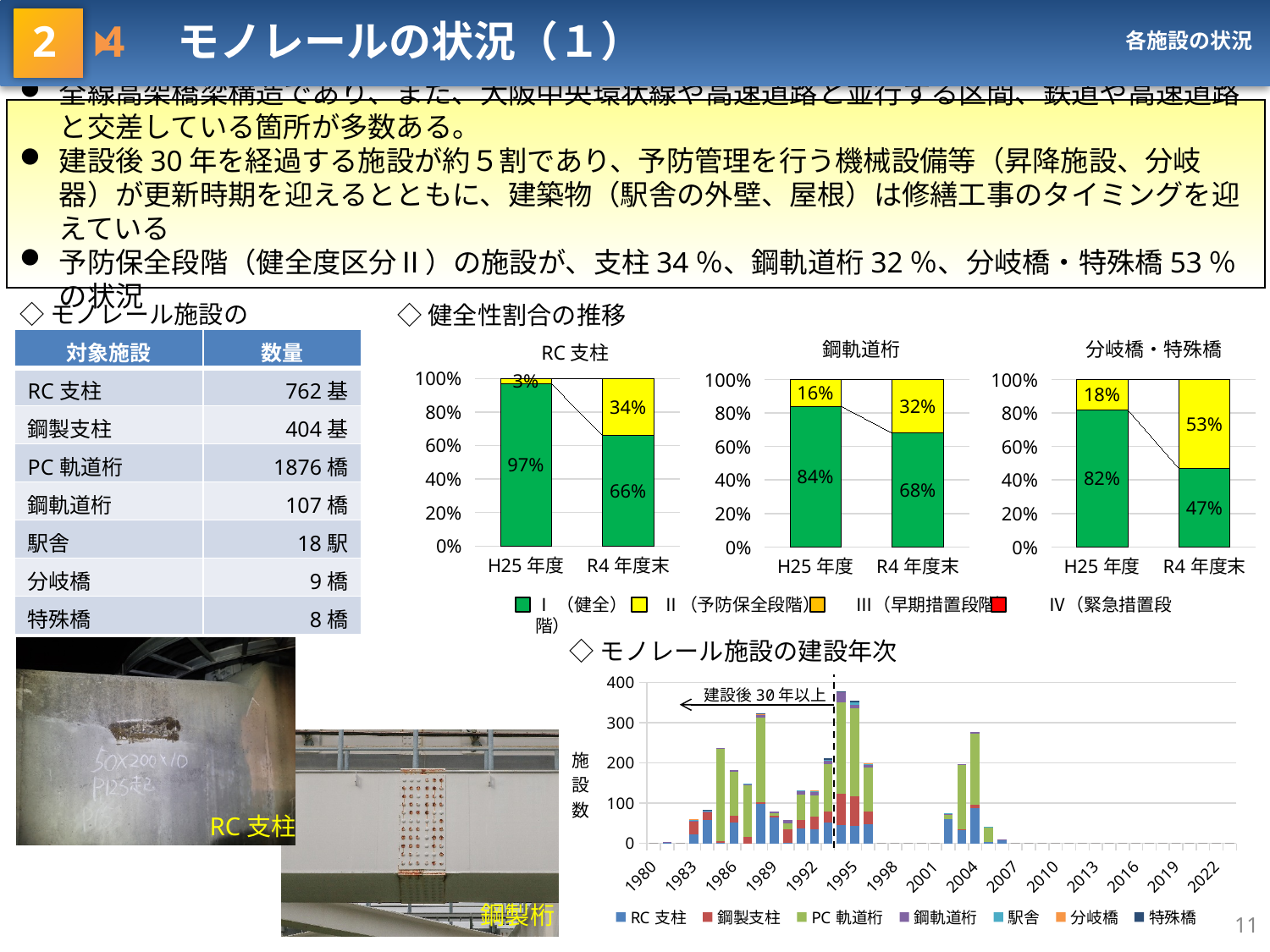
In the RC支柱 chart, how many time periods are plotted on the x axis? 2 In the 鋼軌道桁 chart, what percentage is shown for category I (健全) in H25年度? 84% In the RC支柱 chart, what percentage is shown for category II (予防保全段階) at R4年度末? 34% How many series does the legend of the モノレール施設の建設年次 chart list? 7 In the 分岐橋・特殊橋 chart at R4年度末, which category has the larger share, I (健全) or II (予防保全段階)? II (予防保全段階) In the RC支柱 chart, by how many percentage points did the category I (健全) share fall from H25年度 to R4年度末? 31 percentage points What kind of chart is the モノレール施設の建設年次 chart? Stacked bar chart In the 健全性割合の推移 charts, what colour represents category II (予防保全段階)? Yellow In the 鋼軌道桁 chart, does the share of category I (健全) rise or fall from H25年度 to R4年度末? Fall Among the three 健全性割合の推移 charts, which facility type has the highest category II (予防保全段階) share at R4年度末? 分岐橋・特殊橋 In the モノレール施設の建設年次 chart, is the total number of facilities for 1995 greater or less than 300? greater In the 分岐橋・特殊橋 chart, what percentage is shown for category I (健全) at R4年度末? 47%